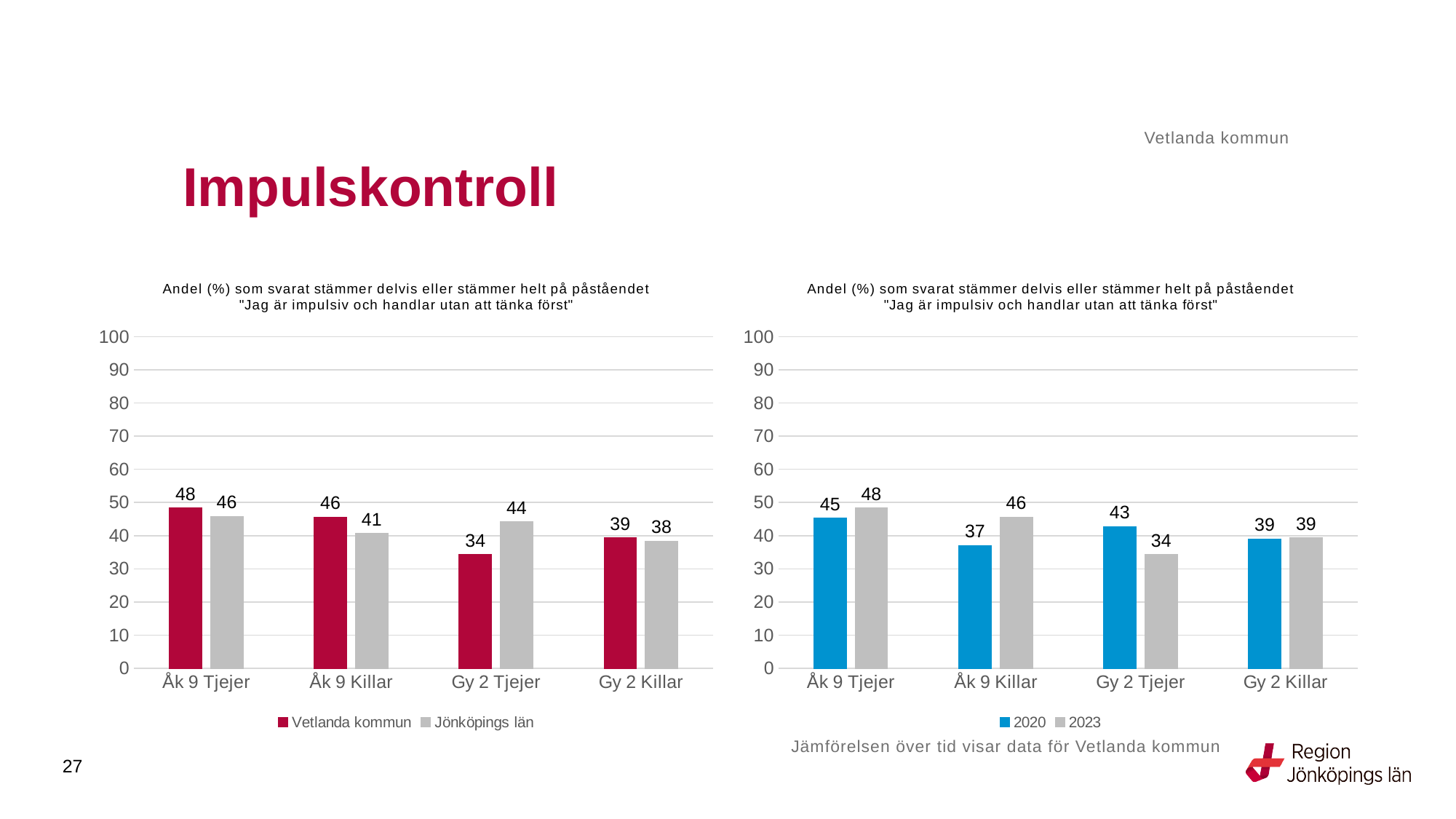
In the right chart, what is the value for 2020 for Gy 2 Tjejer? 43 In the left chart, what is the value for Vetlanda kommun for Åk 9 Tjejer? 48 In the right chart, how many categories are shown on the x axis? 4 What kind of chart is the right chart? Bar chart In the left chart, which category has the lowest value for Vetlanda kommun? Gy 2 Tjejer In the left chart, how many series does the legend list? 2 In the right chart, which category has the highest value for 2023? Åk 9 Tjejer In the left chart, what is the difference between Vetlanda kommun and Jönköpings län for Åk 9 Killar? 5 In the left chart, which is larger for Gy 2 Tjejer: Vetlanda kommun or Jönköpings län? Jönköpings län In the right chart, what is the value for 2023 for Åk 9 Killar? 46 In the right chart, what is the difference between 2020 and 2023 for Åk 9 Killar? 9 In the left chart, what is the value for Jönköpings län for Gy 2 Tjejer? 44